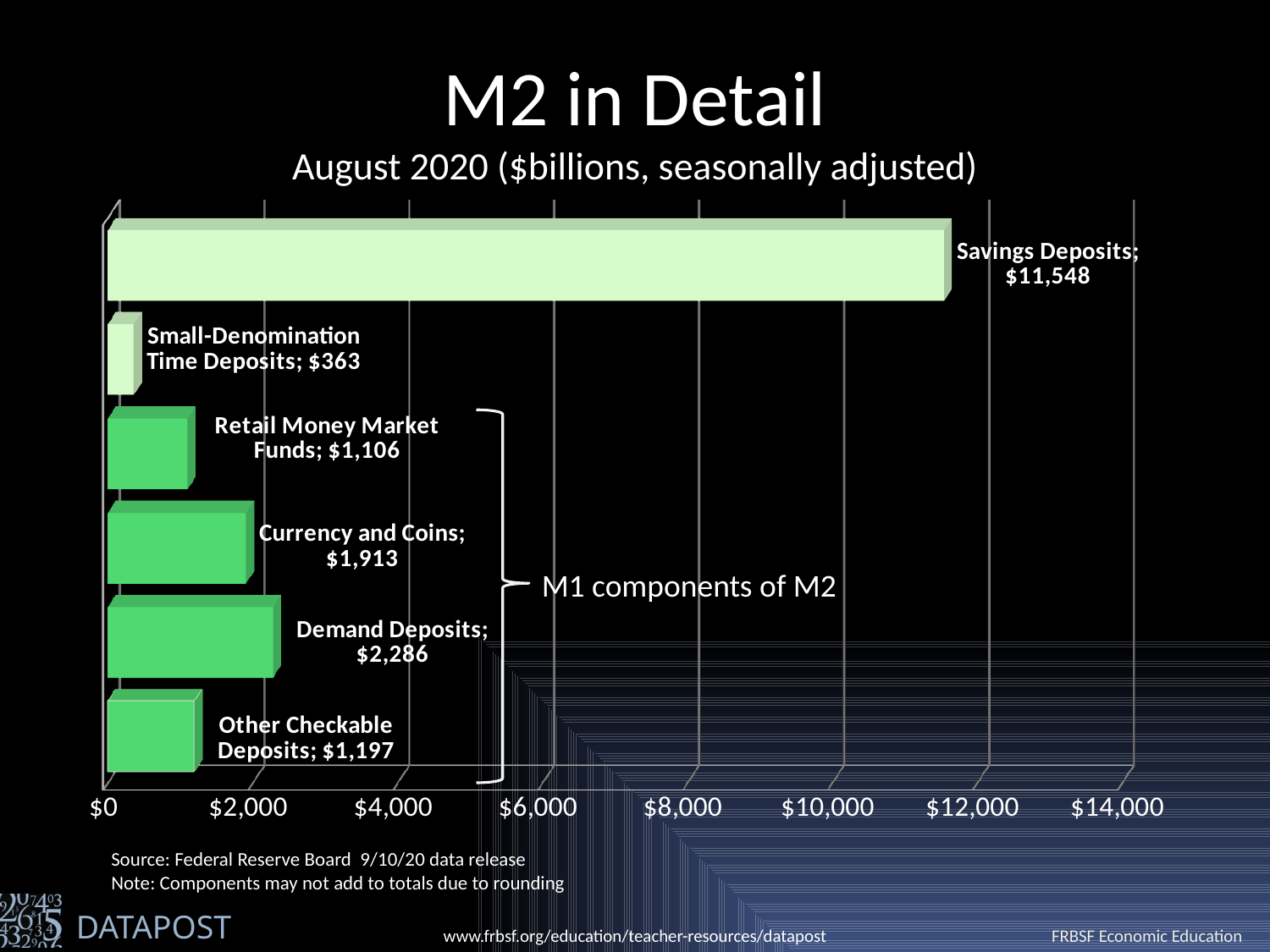
What is the value for Currency and Coins? $1,913 What kind of chart is shown on the slide? bar chart How many categories are shown in the chart? 6 What is the difference between Demand Deposits and Currency and Coins? $373 What is the subtitle of the chart? August 2020 ($billions, seasonally adjusted) Which category has the highest value? Savings Deposits Which is larger, Retail Money Market Funds or Other Checkable Deposits? Other Checkable Deposits What is the value for Small-Denomination Time Deposits? $363 Which category has the lowest value? Small-Denomination Time Deposits What is the total of the four M1 components of M2 shown in the chart? $6,502 What is the value for Savings Deposits? $11,548 Is the value for Demand Deposits greater or less than $2,000? greater